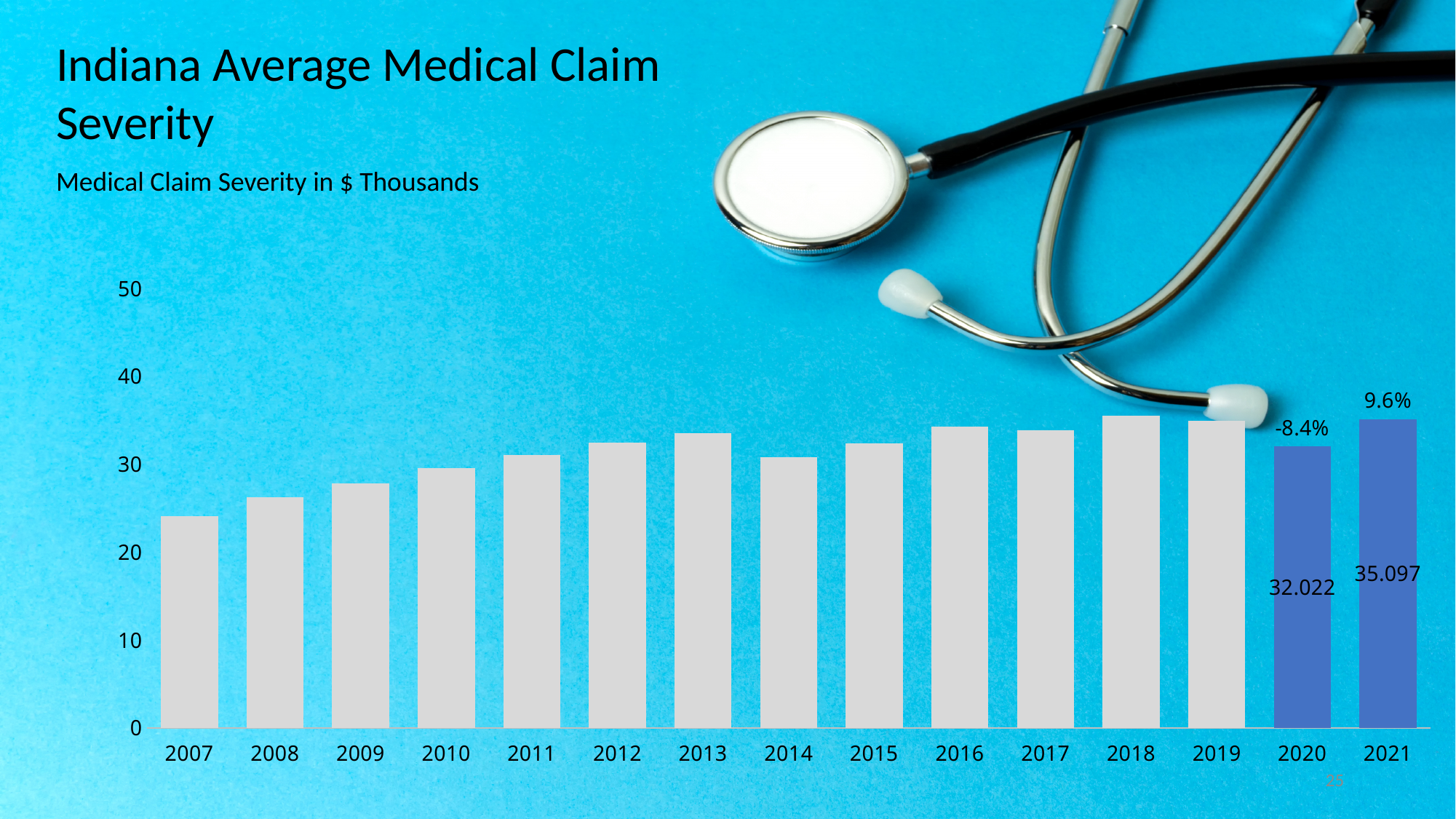
What percentage change is labelled above the 2021 bar? 9.6% How many years are shown on the x axis? 15 Do the values rise or fall from 2007 to 2013? Rise What is the value shown for 2021? 35.097 What percentage change is labelled above the 2020 bar? -8.4% Is the value for 2018 greater or less than 30? greater What kind of chart is shown on the slide? Bar chart What is the value shown for 2020? 32.022 Is the value for 2007 greater or less than 30? less What is the difference between the 2021 value and the 2020 value? 3.075 Which year has the lowest value? 2007 Which year has the larger value, 2020 or 2021? 2021